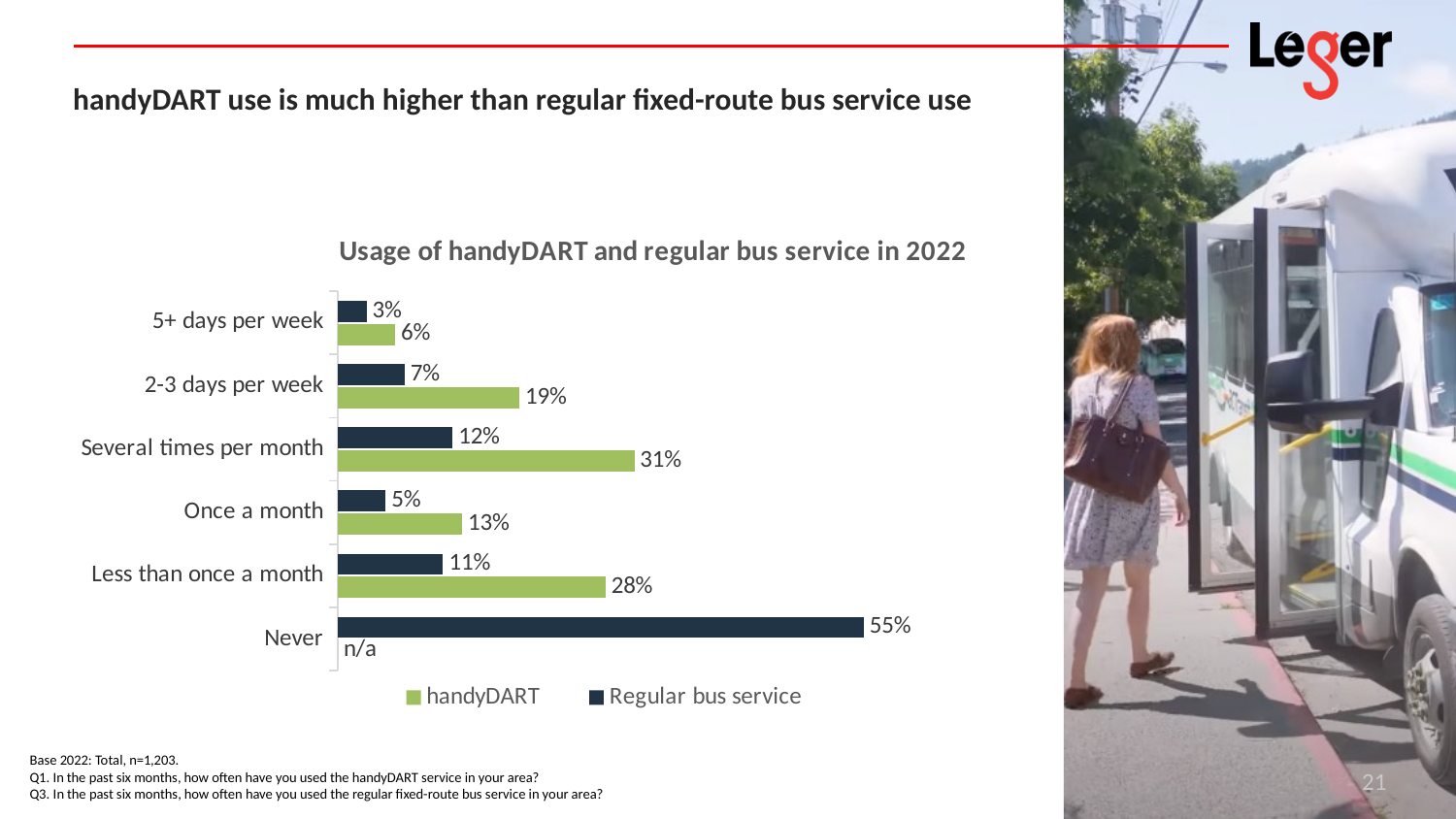
What kind of chart is shown on the slide? bar chart What is the handyDART value for 'Several times per month'? 31% What is the Regular bus service value for 'Less than once a month'? 11% What is the difference between the handyDART and Regular bus service values for 'Once a month'? 8% Which category has the highest handyDART value? Several times per month What is the title of the chart? Usage of handyDART and regular bus service in 2022 What is the handyDART value for '2-3 days per week'? 19% Which category has the lowest Regular bus service value? 5+ days per week How many categories are shown on the chart? 6 For 'Less than once a month', which is larger: the handyDART value or the Regular bus service value? handyDART How many series does the legend list? 2 What is the Regular bus service value for 'Never'? 55%